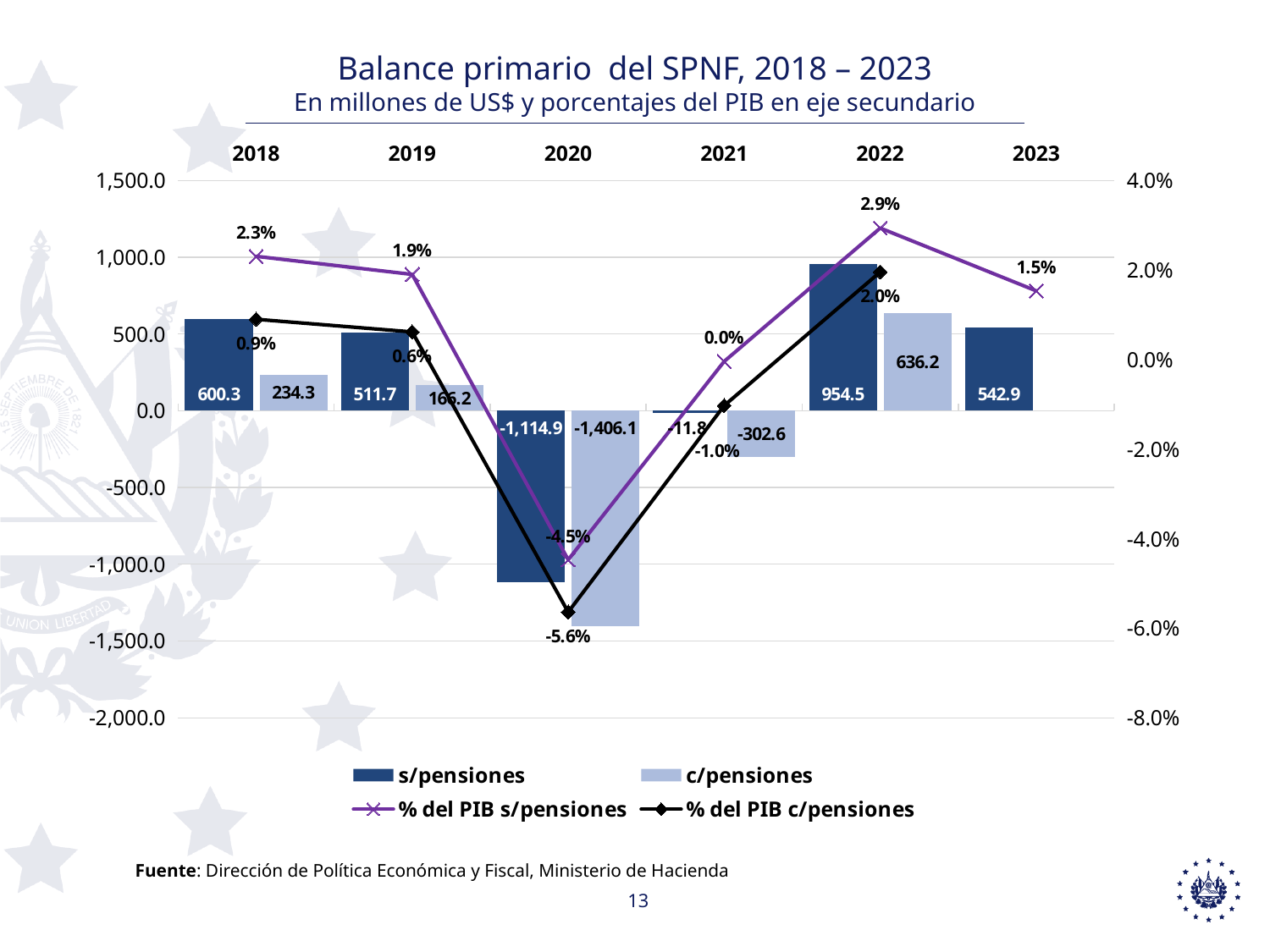
Does the % del PIB s/pensiones line rise or fall from 2020 to 2022? Rises What is the difference between s/pensiones and c/pensiones in 2018? 366.0 What is the % del PIB c/pensiones value for 2021? -1.0% In 2019, which is larger: s/pensiones or c/pensiones? s/pensiones In which year is the s/pensiones bar highest? 2022 How many series does the legend list? 4 What is the % del PIB s/pensiones value for 2023? 1.5% What is the value of s/pensiones for 2022? 954.5 In which year is the % del PIB c/pensiones line at its lowest? 2020 How many years are shown on the x axis? 6 What kind of chart is this? A combination bar and line chart What is the value of c/pensiones for 2020? -1,406.1